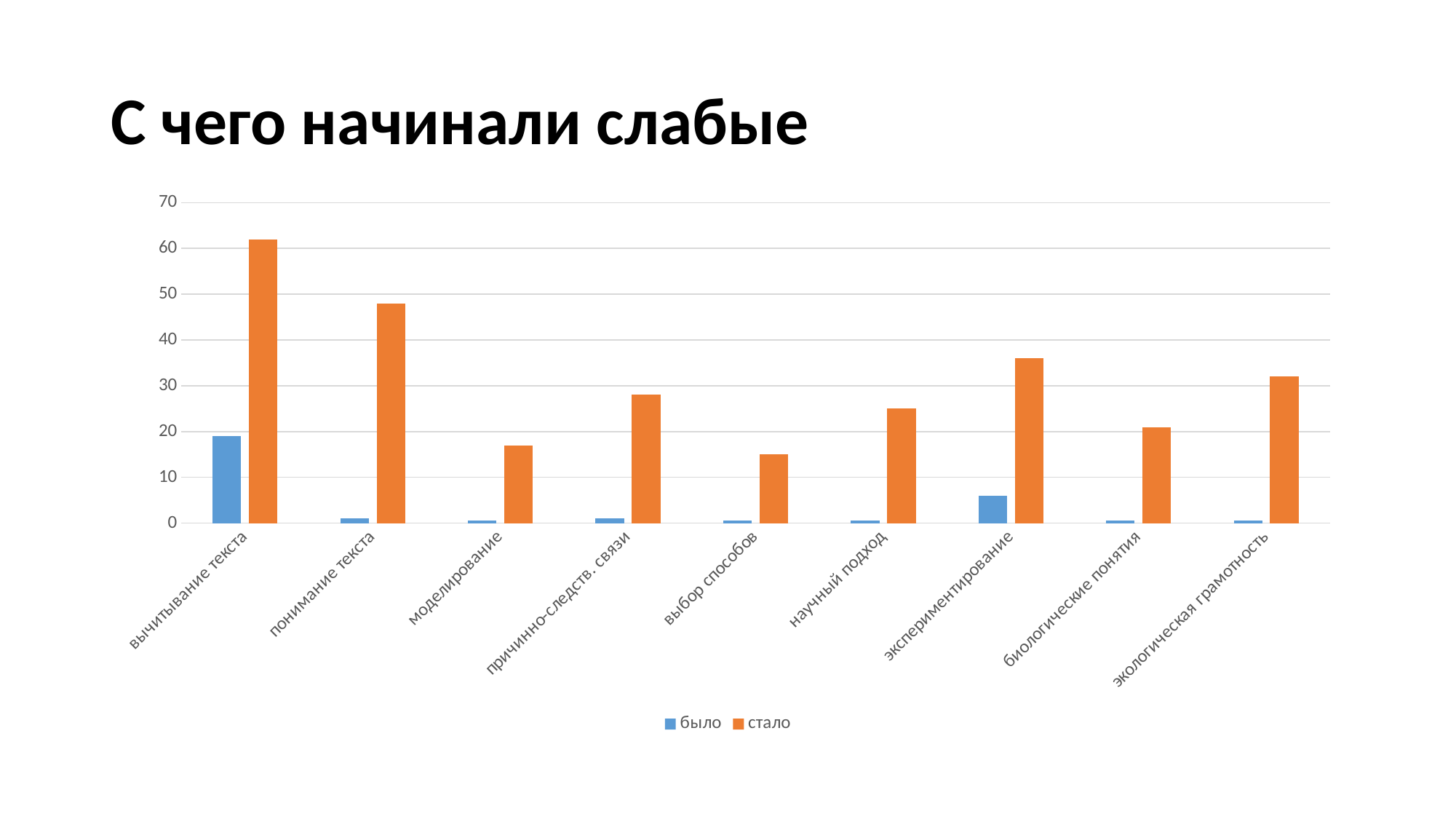
Is the 'стало' value for экспериментирование greater or less than 30? greater Is the 'стало' value for моделирование greater or less than 20? less What is the title of the slide? С чего начинали слабые Is the 'было' value for вычитывание текста greater or less than 10? greater Which has the larger 'стало' value: понимание текста or экспериментирование? понимание текста Which category has the highest value for the 'было' series? вычитывание текста Which category has the highest value for the 'стало' series? вычитывание текста What kind of chart is shown on the slide? bar chart How many categories are shown on the x axis? 9 How many series does the legend list? 2